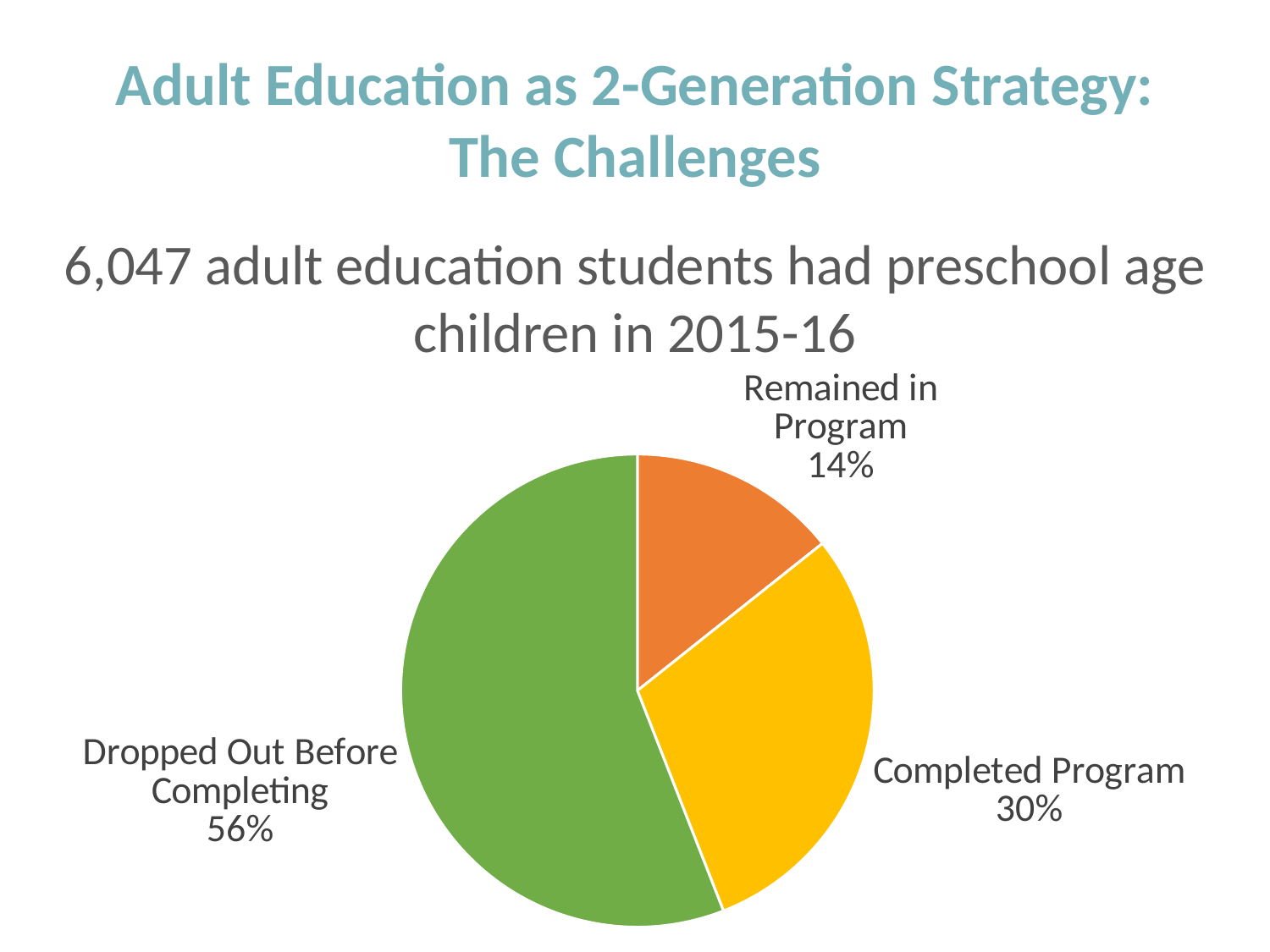
How many adult education students had preschool age children in 2015-16, according to the slide? 6,047 Which category has the largest slice of the pie? Dropped Out Before Completing Which is larger, the share for Completed Program or the share for Remained in Program? Completed Program How many slices does the pie chart have? 3 What is the difference in percentage points between Completed Program and Remained in Program? 16 What colour is the slice for Dropped Out Before Completing? green What share of students Remained in Program? 14% What share of students Completed Program? 30% Which category has the smallest slice of the pie? Remained in Program What kind of chart is shown on the slide? pie chart What share of students Dropped Out Before Completing? 56% What is the difference in percentage points between Dropped Out Before Completing and Completed Program? 26